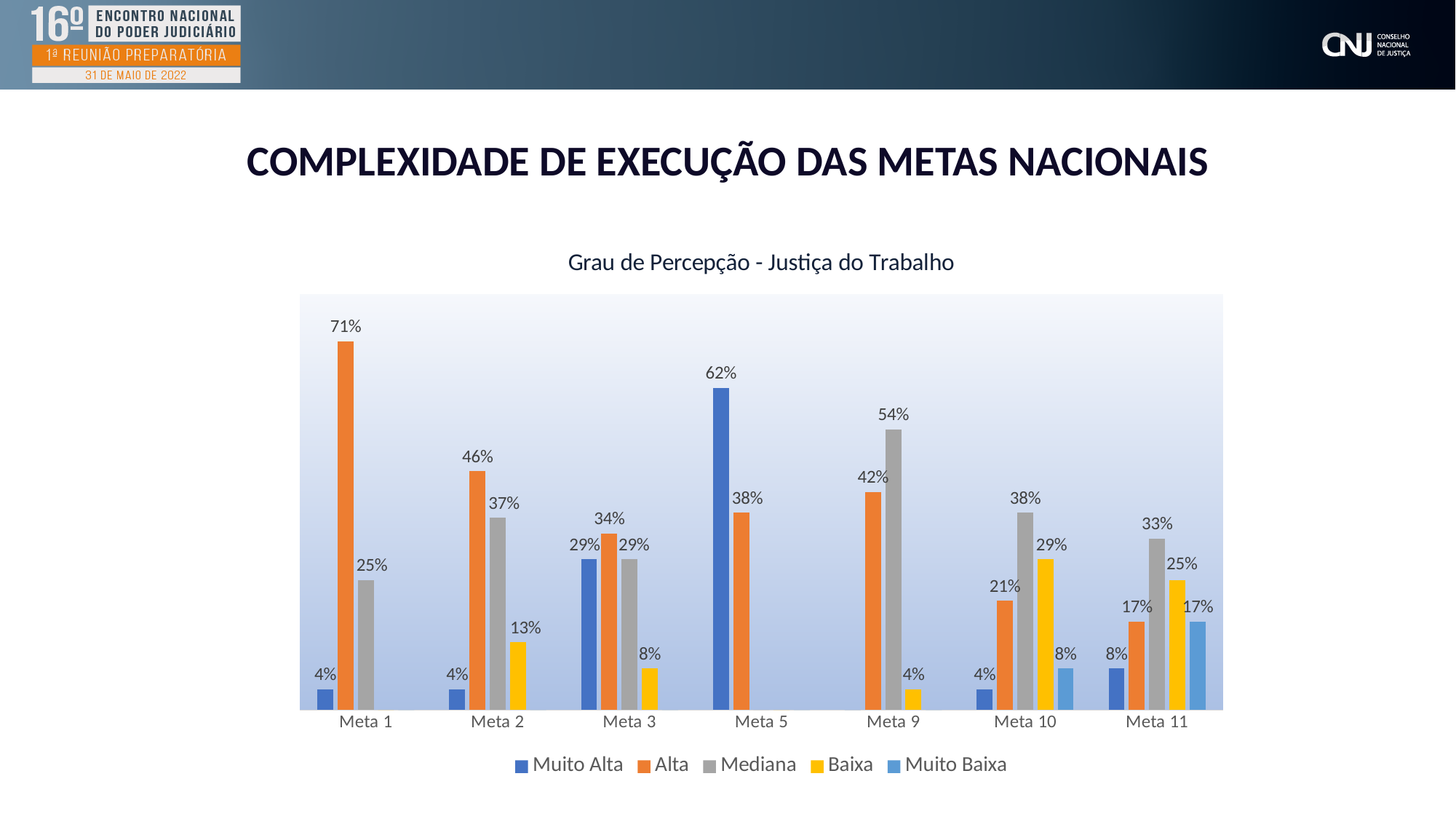
What is the value of the Alta series for Meta 1? 71% What is the value of the Muito Alta series for Meta 5? 62% Which category has the lowest value in the Alta series? Meta 11 Which category has the highest value in the Muito Alta series? Meta 5 What kind of chart is shown on the slide? Bar chart What is the value of the Baixa series for Meta 10? 29% What is the difference between the Alta value for Meta 1 and the Alta value for Meta 2? 25% What is the value of the Mediana series for Meta 9? 54% How many categories (Metas) are shown on the x axis? 7 How many series does the legend list? 5 For Meta 11, which is larger: the Mediana value or the Baixa value? Mediana What is the title of the chart? Grau de Percepção - Justiça do Trabalho